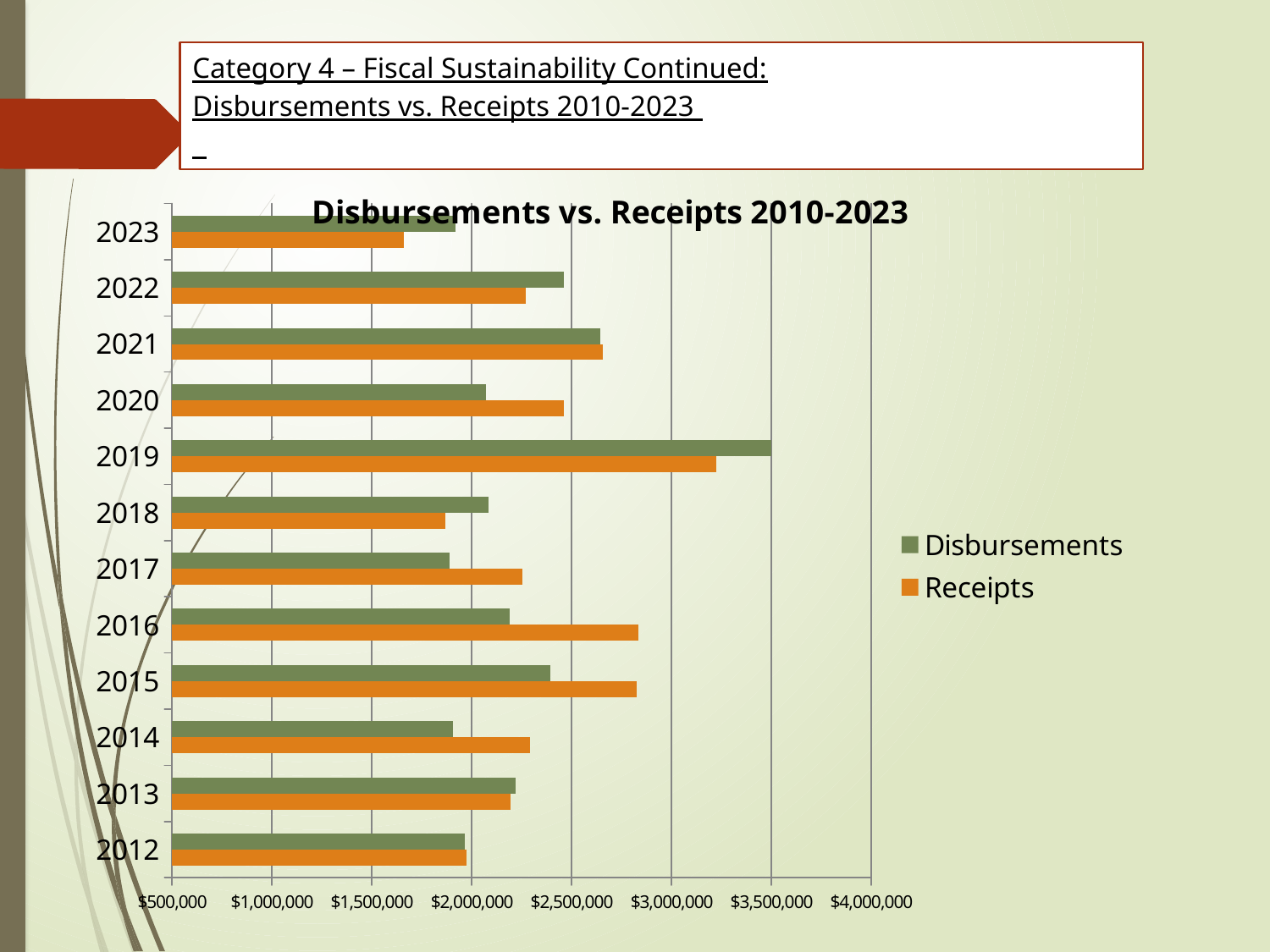
Which colour represents Receipts in the chart? Orange Which year has the highest Receipts value? 2019 Which year has the lowest Receipts value? 2023 In 2016, which is larger, Disbursements or Receipts? Receipts How many years are plotted on the chart? 12 What is the title of the chart? Disbursements vs. Receipts 2010-2023 Is the Receipts value for 2016 greater or less than $2,500,000? greater Is the Disbursements value for 2019 greater or less than $3,000,000? greater What type of chart is shown on the slide? Bar chart Which year has the highest Disbursements value? 2019 How many series does the chart legend list? 2 Is the Receipts value for 2023 greater or less than $2,000,000? less